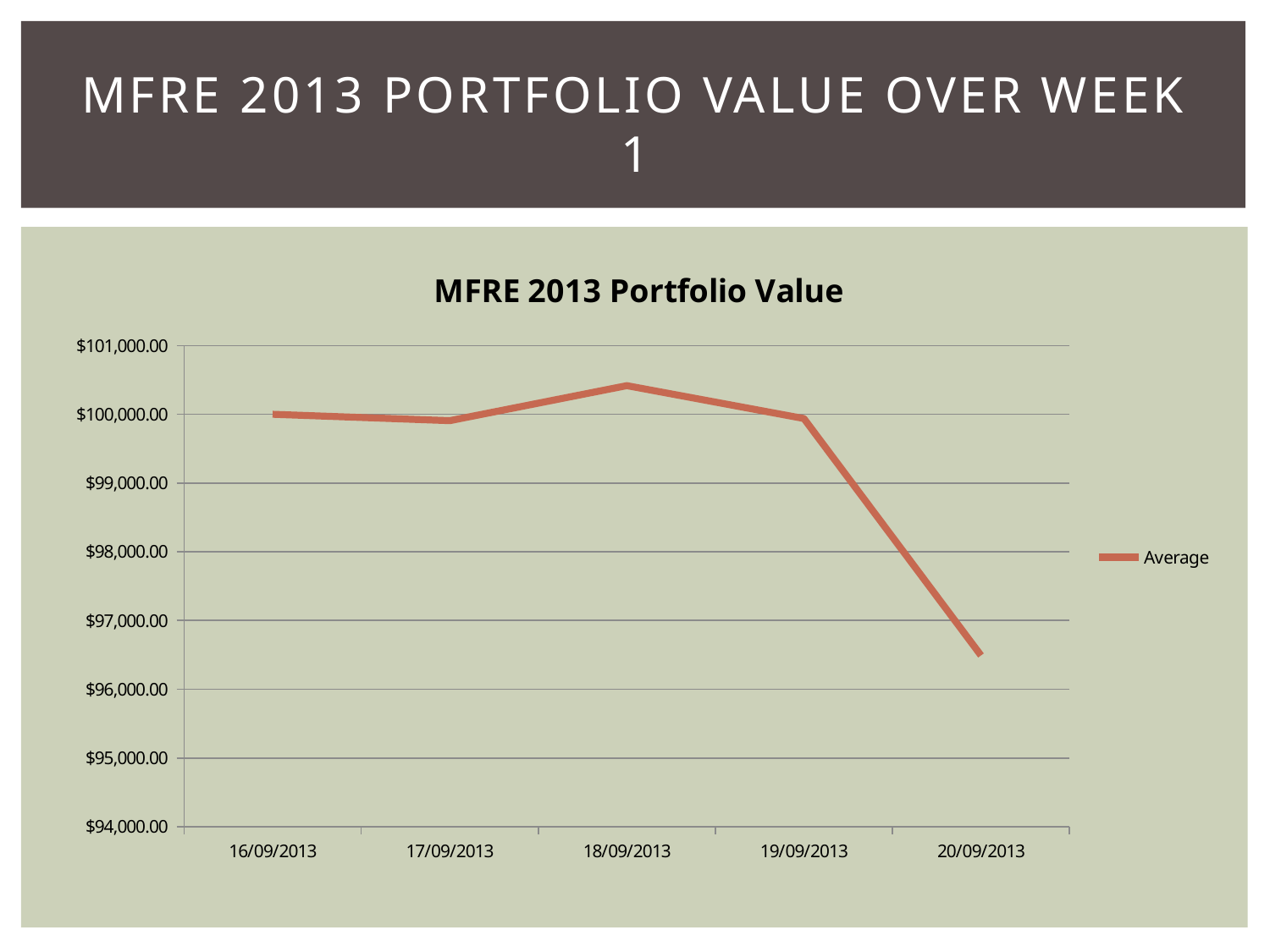
How many dates are plotted along the x axis of the chart? 5 What kind of chart is shown on the slide? line chart Does the portfolio value rise or fall between 19/09/2013 and 20/09/2013? fall Is the value for 20/09/2013 greater or less than $97,000.00? less What is the name of the series shown in the chart's legend? Average On which date is the portfolio value lowest? 20/09/2013 What is the title of the chart? MFRE 2013 Portfolio Value How many series does the chart's legend list? 1 On which date is the portfolio value highest? 18/09/2013 Is the value for 18/09/2013 greater or less than $100,000.00? greater Is the value for 20/09/2013 greater or less than $96,000.00? greater Which date has the larger portfolio value, 19/09/2013 or 20/09/2013? 19/09/2013